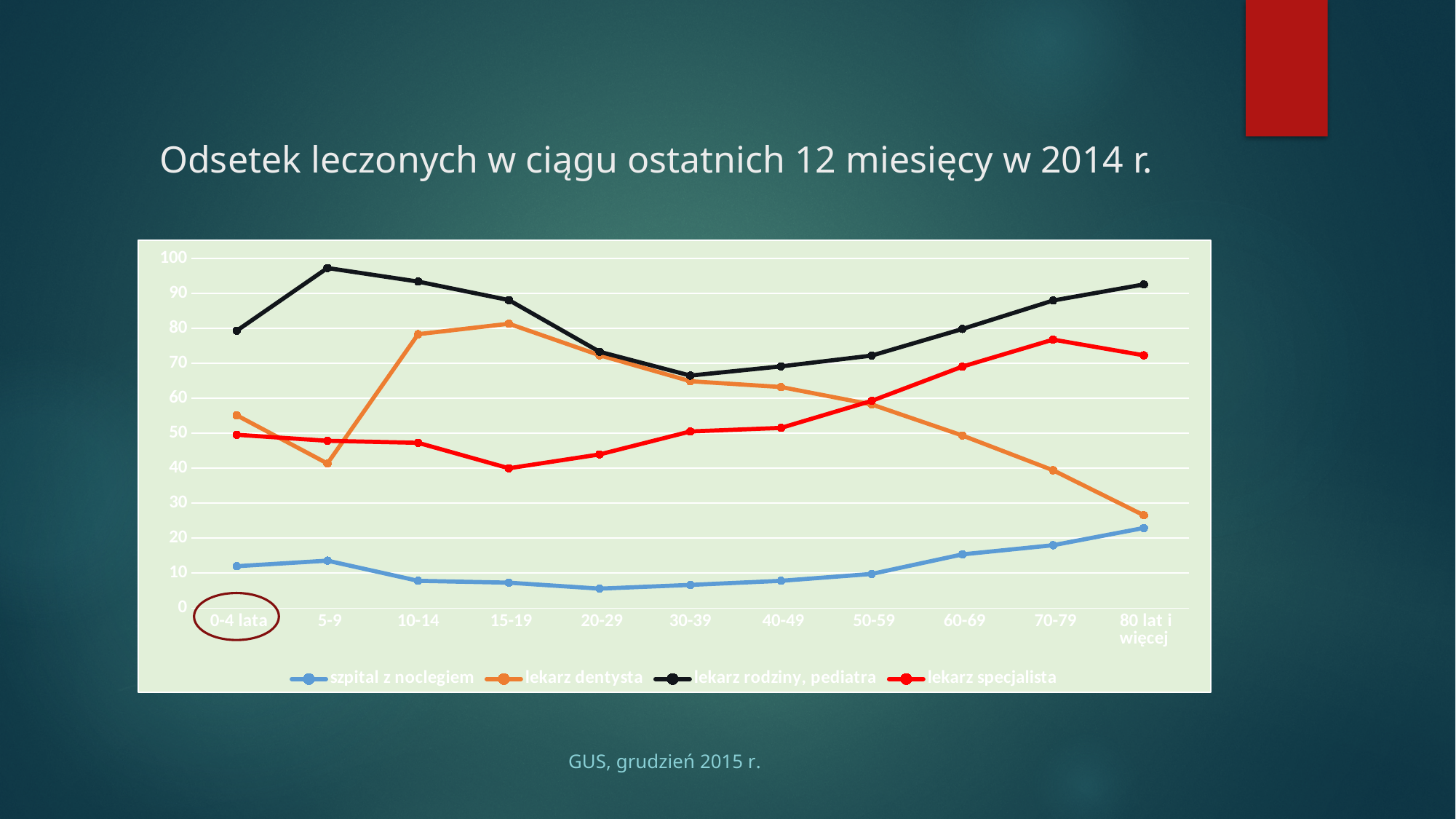
Is the value for 'lekarz rodziny, pediatra' at 5-9 greater or less than 90? greater At 70-79, which is larger: 'lekarz dentysta' or 'lekarz specjalista'? lekarz specjalista For which age category is the value for 'lekarz rodziny, pediatra' highest? 5-9 For which age category is the value for 'lekarz specjalista' lowest? 15-19 Which age category on the x axis is circled? 0-4 lata What kind of chart is shown on the slide? line chart How many series does the legend list? 4 Is the value for 'lekarz dentysta' at 5-9 greater or less than 50? less How many age categories are shown on the x axis? 11 For which age category is the value for 'lekarz dentysta' lowest? 80 lat i więcej For which age category is the value for 'lekarz specjalista' highest? 70-79 Does the value for 'szpital z noclegiem' rise or fall from 50-59 to 80 lat i więcej? rise